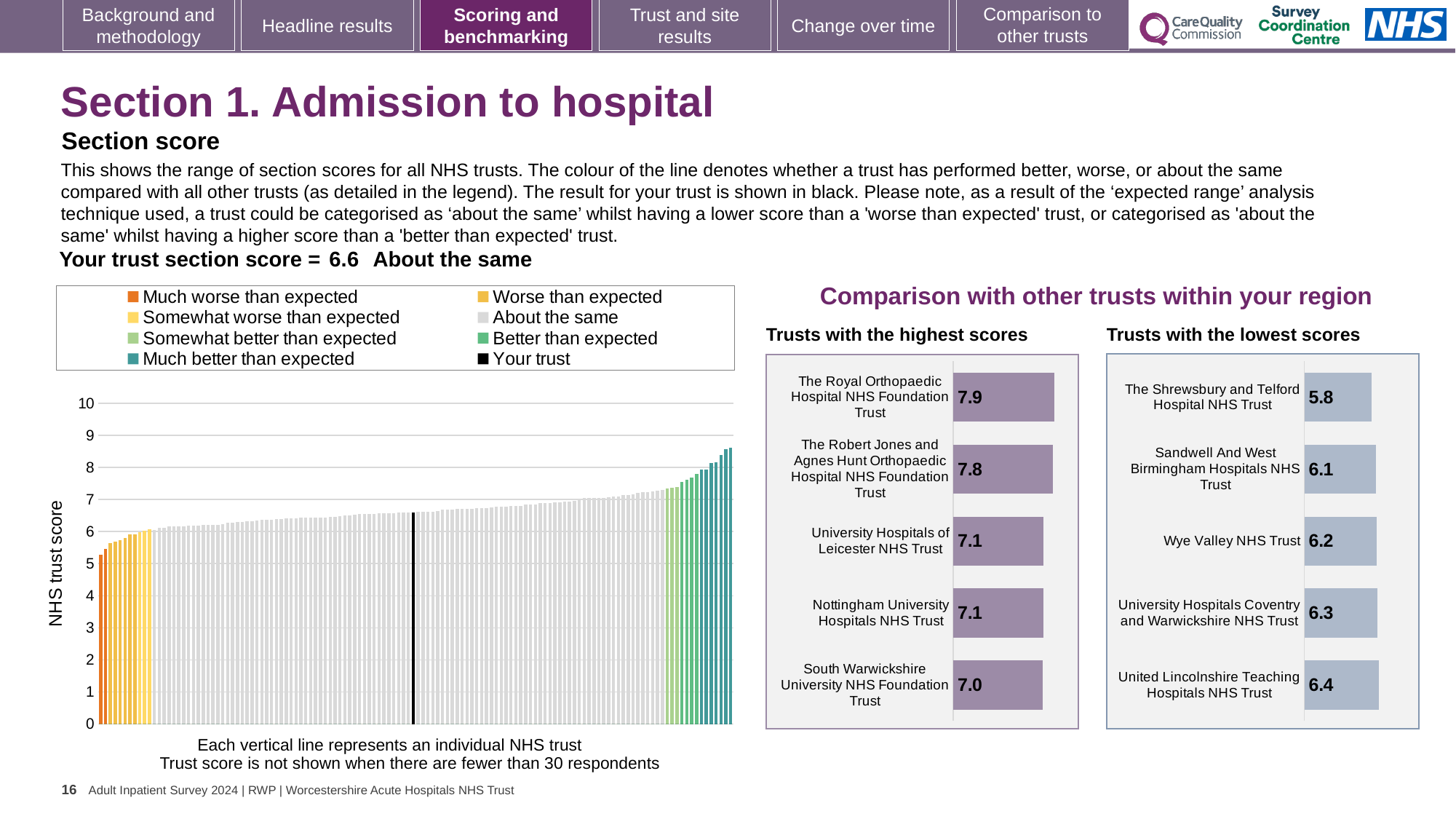
In the large chart on the left showing all NHS trusts, what is the section score for your trust (the black line)? 6.6 How many entries does the legend of the large chart on the left list? 8 In the large chart on the left showing all NHS trusts, do the trust scores rise or fall from left to right along the x axis? rise In the 'Trusts with the highest scores' chart, what is the score for The Royal Orthopaedic Hospital NHS Foundation Trust? 7.9 In the 'Trusts with the highest scores' chart, which trust has the lowest score shown? South Warwickshire University NHS Foundation Trust In the 'Trusts with the lowest scores' chart, which trust has the lowest score? The Shrewsbury and Telford Hospital NHS Trust In the 'Trusts with the highest scores' chart, what is the difference between the scores of The Royal Orthopaedic Hospital NHS Foundation Trust and South Warwickshire University NHS Foundation Trust? 0.9 In the 'Trusts with the lowest scores' chart, what is the difference between the scores of United Lincolnshire Teaching Hospitals NHS Trust and The Shrewsbury and Telford Hospital NHS Trust? 0.6 In the 'Trusts with the lowest scores' chart, what is the score for Wye Valley NHS Trust? 6.2 In the 'Trusts with the lowest scores' chart, which trust has the highest score shown? United Lincolnshire Teaching Hospitals NHS Trust How many trusts are listed in the 'Trusts with the highest scores' chart? 5 Which has a higher score: Sandwell And West Birmingham Hospitals NHS Trust in the lowest scores chart, or University Hospitals of Leicester NHS Trust in the highest scores chart? University Hospitals of Leicester NHS Trust